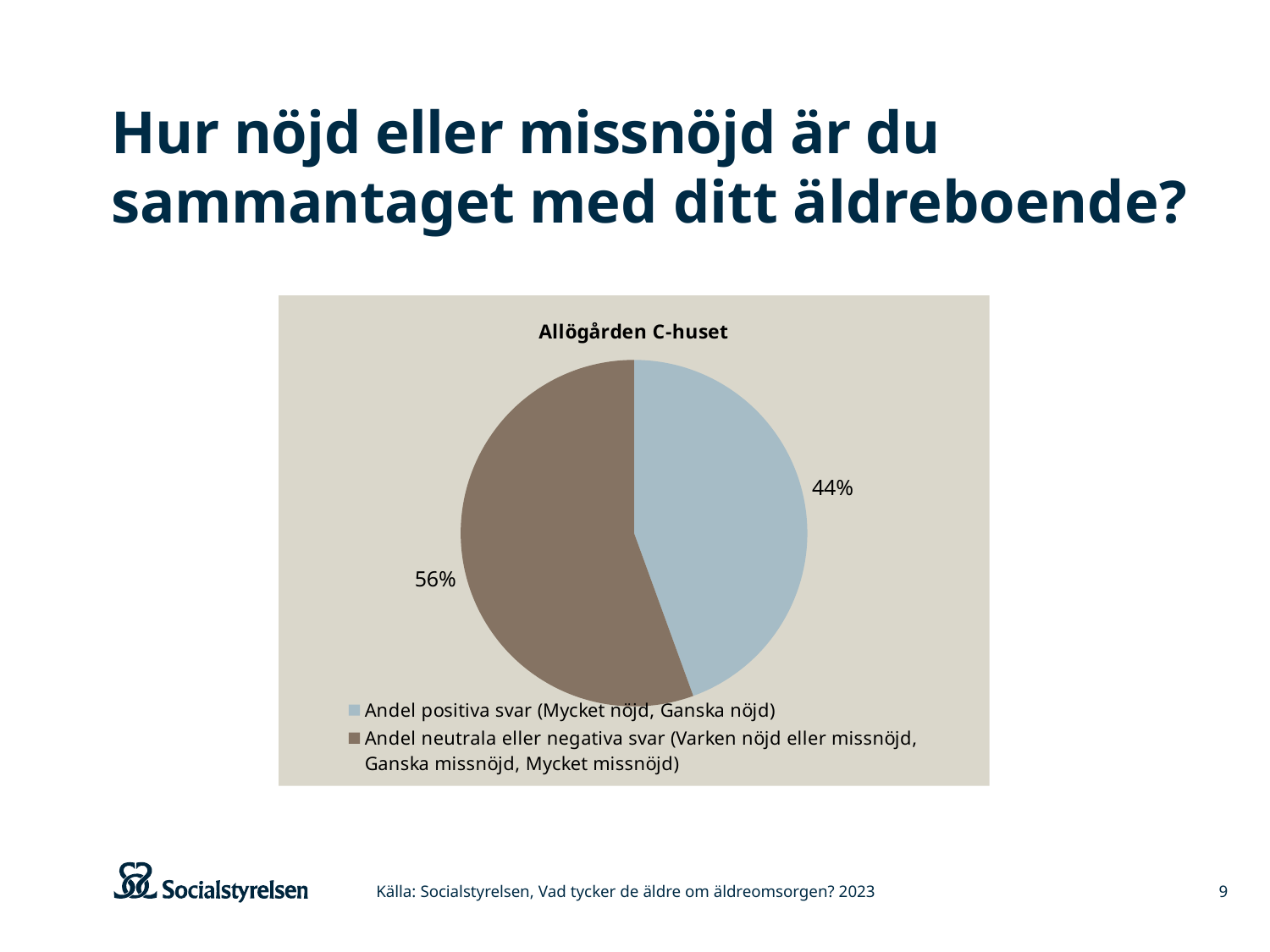
Which slice is the largest? Andel neutrala eller negativa svar (Varken nöjd eller missnöjd, Ganska missnöjd, Mycket missnöjd) Which slice is the smallest? Andel positiva svar (Mycket nöjd, Ganska nöjd) How many slices does the pie chart have? 2 What share of the pie is 'Andel positiva svar (Mycket nöjd, Ganska nöjd)'? 44% What share of the pie is 'Andel neutrala eller negativa svar (Varken nöjd eller missnöjd, Ganska missnöjd, Mycket missnöjd)'? 56% Which is larger: the share of positive answers or the share of neutral or negative answers? Andel neutrala eller negativa svar How many entries does the legend list? 2 What is the difference in percentage points between the neutral/negative slice and the positive slice? 12 What colour is the slice for 'Andel positiva svar (Mycket nöjd, Ganska nöjd)'? light blue What is the chart's title? Allögården C-huset What kind of chart is shown on the slide? pie chart